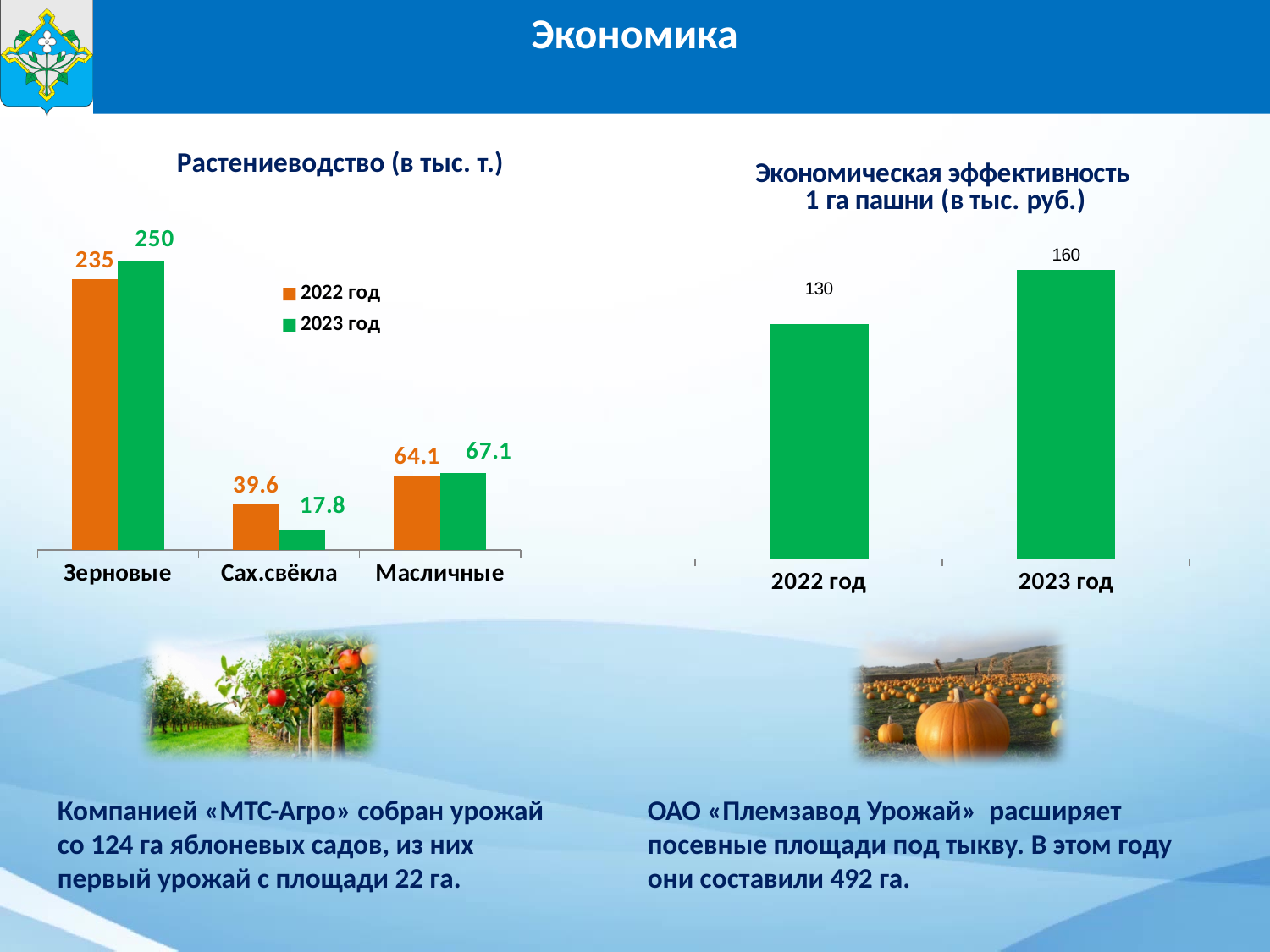
In the chart 'Растениеводство (в тыс. т.)', which category has the highest value in 2022 год? Зерновые In the chart 'Растениеводство (в тыс. т.)', what is the difference between the 2022 год and 2023 год values for Сах.свёкла? 21.8 How many categories are shown on the x axis of the chart 'Растениеводство (в тыс. т.)'? 3 In the chart 'Растениеводство (в тыс. т.)', which is larger for Масличные: the 2022 год value or the 2023 год value? 2023 год In the chart 'Растениеводство (в тыс. т.)', which category has the lowest value in 2023 год? Сах.свёкла In the chart 'Экономическая эффективность 1 га пашни (в тыс. руб.)', what is the value for 2022 год? 130 In the chart 'Растениеводство (в тыс. т.)', what is the value for Масличные in 2023 год? 67.1 What kind of chart is 'Экономическая эффективность 1 га пашни (в тыс. руб.)'? Bar chart In the chart 'Растениеводство (в тыс. т.)', what is the value for Зерновые in 2023 год? 250 In the chart 'Растениеводство (в тыс. т.)', what is the value for Сах.свёкла in 2022 год? 39.6 How many series does the legend of the chart 'Растениеводство (в тыс. т.)' list? 2 In the chart 'Экономическая эффективность 1 га пашни (в тыс. руб.)', what is the difference between the 2023 год and 2022 год values? 30